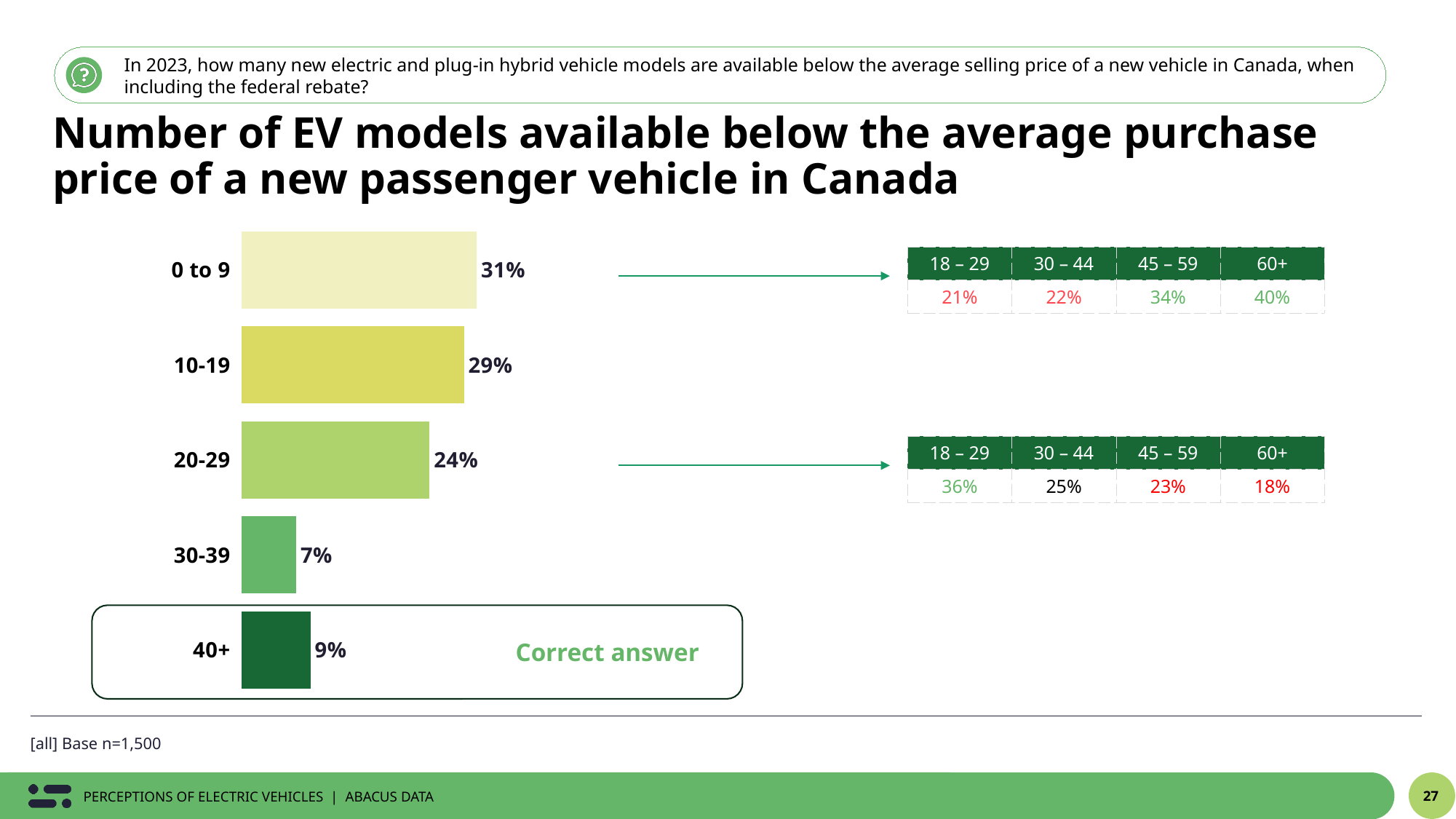
How many response categories are shown in the bar chart? 5 What percentage of respondents answered "0 to 9"? 31% What percentage of respondents answered "20-29"? 24% In the age breakdown for the "0 to 9" response, what percentage of those aged 60+ chose it? 40% What is the difference in percentage points between the "0 to 9" and "10-19" categories? 2 Which response category has the lowest percentage? 30-39 What type of chart is used to show the responses? Bar chart In the age breakdown for the "20-29" response, what percentage of those aged 18 – 29 chose it? 36% What percentage of respondents answered "40+"? 9% Which category is marked as the correct answer? 40+ Which response category has the highest percentage? 0 to 9 Which category has a larger share, "30-39" or "40+"? 40+